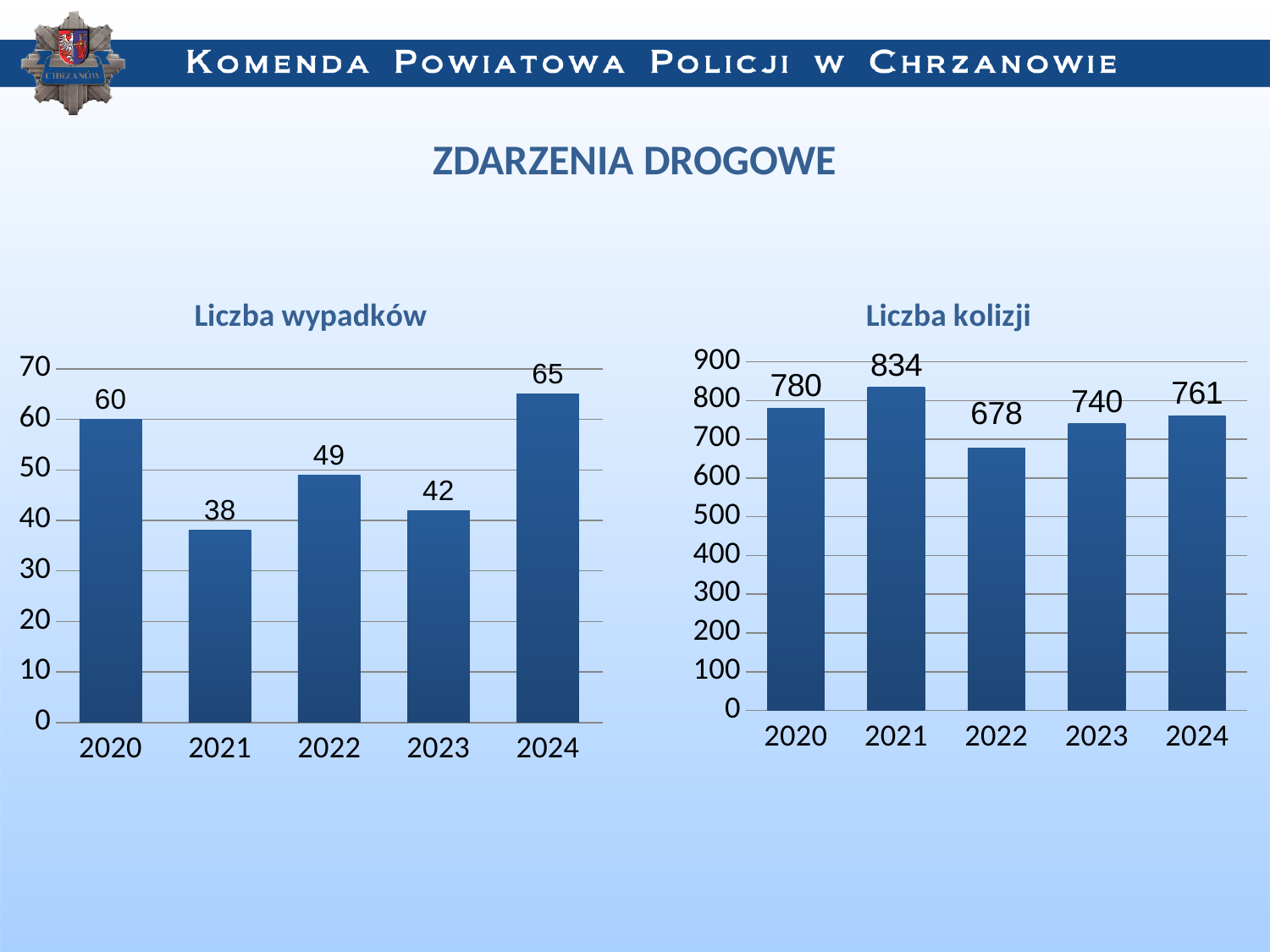
In the 'Liczba kolizji' chart, which year has the lowest value? 2022 In the 'Liczba kolizji' chart, which is larger, the value for 2023 or the value for 2024? 2024 What is the title of the chart on the right side of the slide? Liczba kolizji In the 'Liczba wypadków' chart, what is the value for 2021? 38 In the 'Liczba wypadków' chart, which year has the highest value? 2024 In the 'Liczba wypadków' chart, what is the difference between the values for 2024 and 2023? 23 How many years are shown on the x axis of the 'Liczba kolizji' chart? 5 In the 'Liczba wypadków' chart, is the value for 2022 greater or less than 40? greater In the 'Liczba kolizji' chart, what is the value for 2023? 740 In the 'Liczba wypadków' chart, does the value rise or fall from 2020 to 2021? fall What kind of chart is the 'Liczba wypadków' chart? bar chart In the 'Liczba kolizji' chart, what is the difference between the values for 2021 and 2020? 54